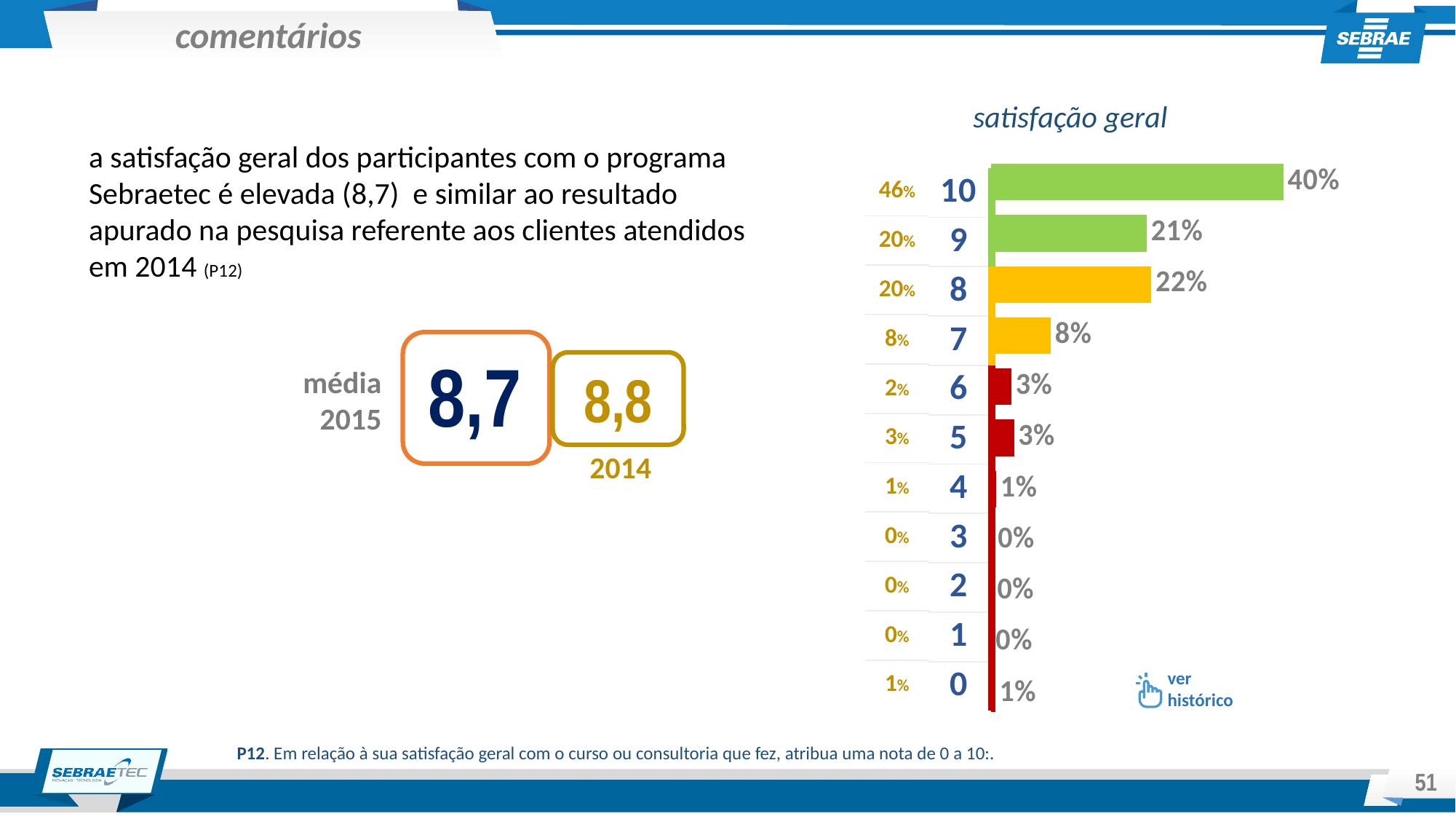
What is the title of the chart on the slide? satisfação geral How many score categories are shown in the "satisfação geral" chart? 11 In the "satisfação geral" chart, which has a larger percentage, score 8 or score 9? score 8 What kind of chart is shown under the title "satisfação geral"? bar chart What is the average (média) satisfaction score shown for 2015 on the slide? 8,7 In the "satisfação geral" chart, what percentage is shown for score 7? 8% In the "satisfação geral" chart, which score has the highest percentage? 10 In the "satisfação geral" chart, what is the difference between the percentages for score 10 and score 9? 19% In the "satisfação geral" chart, what percentage is shown for score 0? 1% In the "satisfação geral" chart, what percentage of participants gave a score of 10? 40% In the "satisfação geral" chart, what is the combined percentage for scores 9 and 10? 61% In the "satisfação geral" chart, what percentage is shown for score 8? 22%